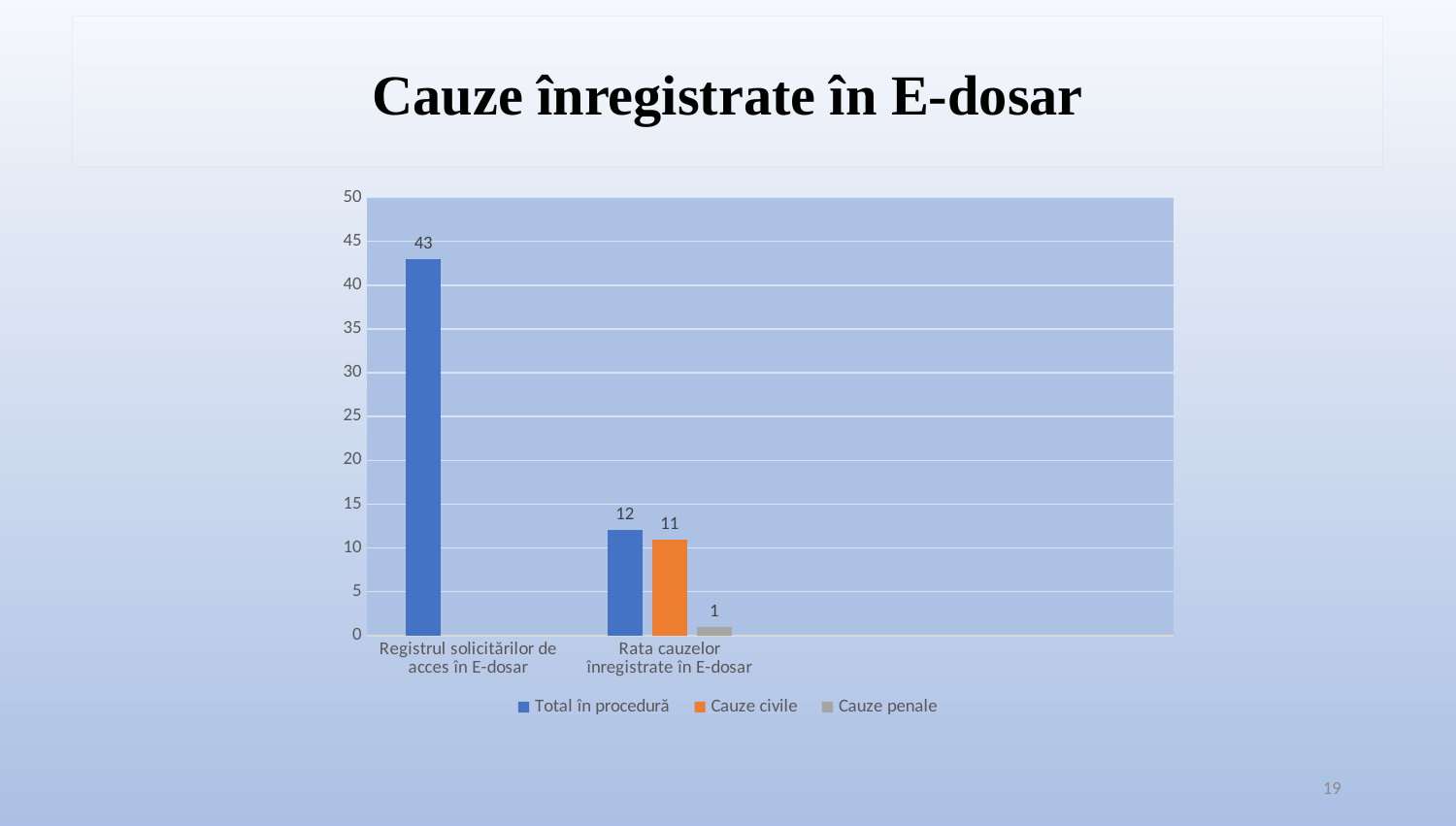
What is the value of "Cauze civile" for "Rata cauzelor înregistrate în E-dosar"? 11 What is the difference between "Total în procedură" for "Registrul solicitărilor de acces în E-dosar" and for "Rata cauzelor înregistrate în E-dosar"? 31 What is the value of "Cauze penale" for "Rata cauzelor înregistrate în E-dosar"? 1 What is the value of "Total în procedură" for "Rata cauzelor înregistrate în E-dosar"? 12 What is the title of the chart? Cauze înregistrate în E-dosar Which is larger for "Rata cauzelor înregistrate în E-dosar": "Total în procedură" or "Cauze civile"? Total în procedură What kind of chart is shown on the slide? Bar chart What is the difference between "Cauze civile" and "Cauze penale" for "Rata cauzelor înregistrate în E-dosar"? 10 How many series does the legend list? 3 Which series has the lowest value for "Rata cauzelor înregistrate în E-dosar"? Cauze penale Which category has the highest "Total în procedură" value? Registrul solicitărilor de acces în E-dosar What is the value of "Total în procedură" for "Registrul solicitărilor de acces în E-dosar"? 43